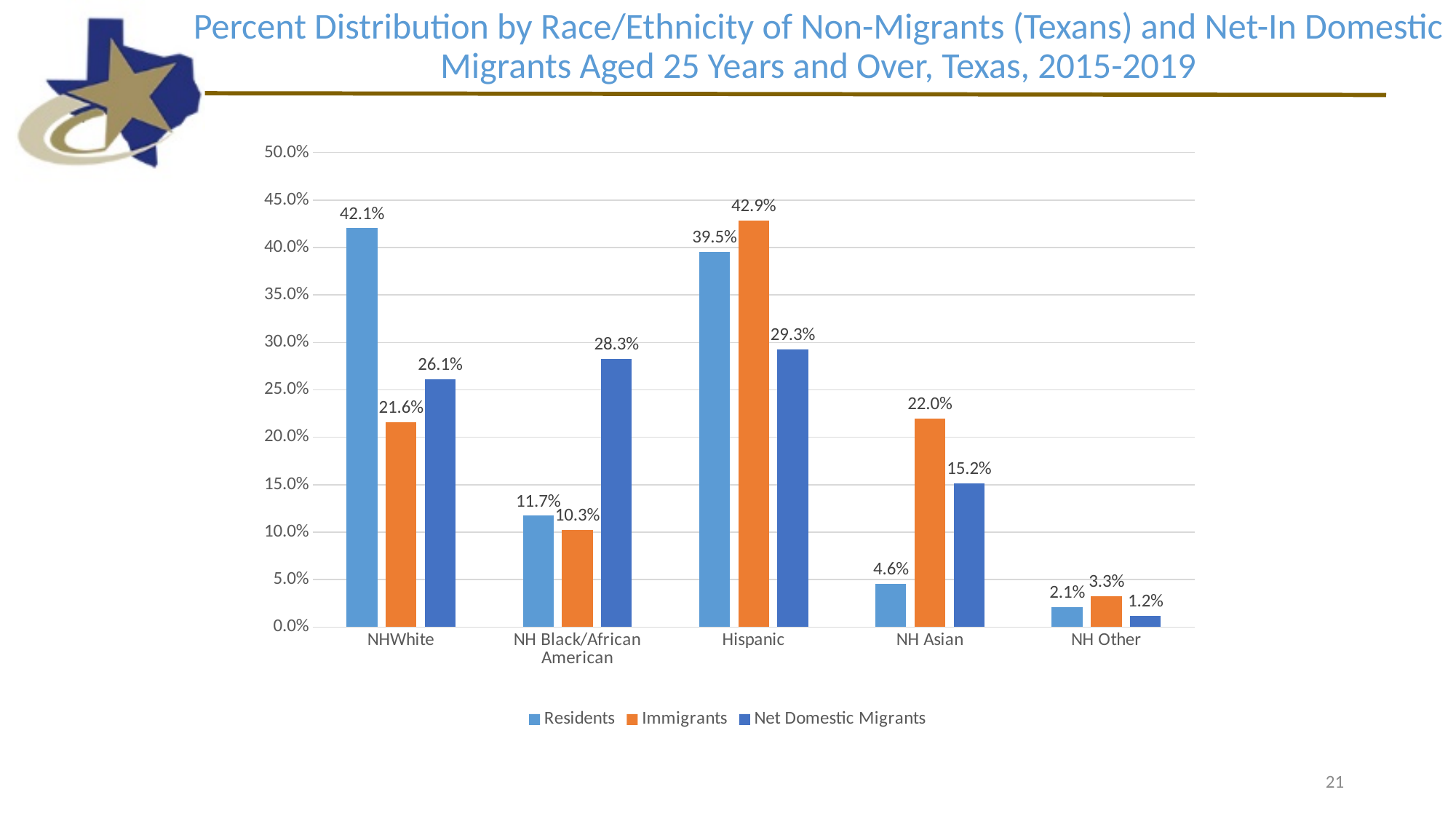
What is the difference between the Immigrants and Residents values for Hispanic? 3.4% Which category has the lowest Net Domestic Migrants value? NH Other How many series does the legend list? 3 What kind of chart is shown on the slide? Bar chart How many race/ethnicity categories are shown on the x axis? 5 Is the Net Domestic Migrants value for Hispanic greater or less than 25.0%? greater What is the Net Domestic Migrants value for NH Black/African American? 28.3% Which category has the highest Immigrants value? Hispanic What is the Immigrants value for NH Asian? 22.0% Which is larger for NHWhite: the Immigrants value or the Net Domestic Migrants value? Net Domestic Migrants What is the Residents value for NHWhite? 42.1% Which series is shown in orange in the legend? Immigrants